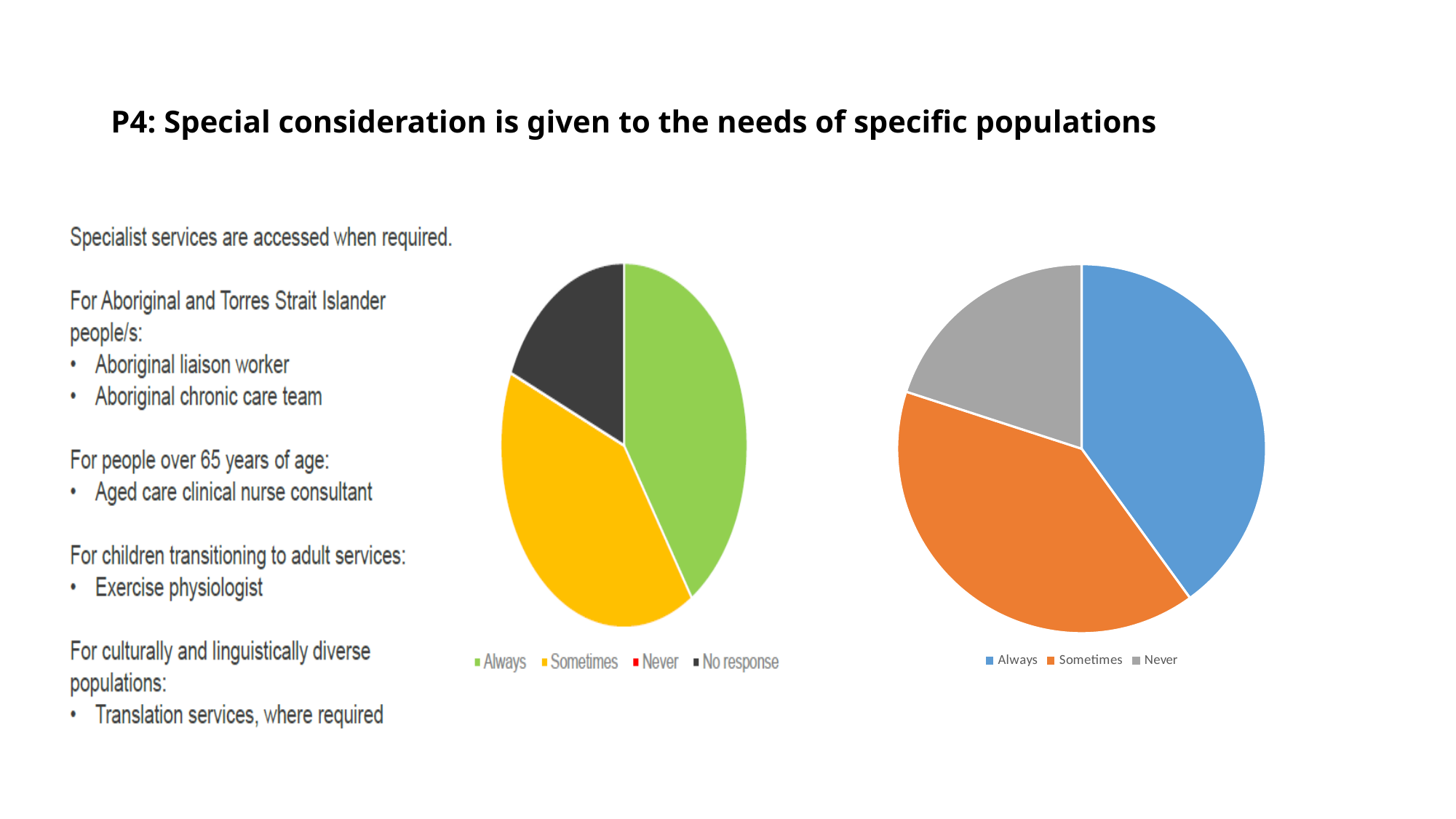
In the left pie chart, which slice is larger: Sometimes or No response? Sometimes How many entries does the legend of the right pie chart list? 3 In the right pie chart, which category has the smallest slice? Never What kind of chart is the right chart on the slide? pie chart In the left pie chart, which slice is larger: Always or No response? Always In the right pie chart, which slice is larger: Sometimes or Never? Sometimes In the left pie chart, what colour represents the Sometimes category? yellow What kind of chart is the left chart on the slide? pie chart In the right pie chart, what colour represents the Always category? blue How many entries does the legend of the left pie chart list? 4